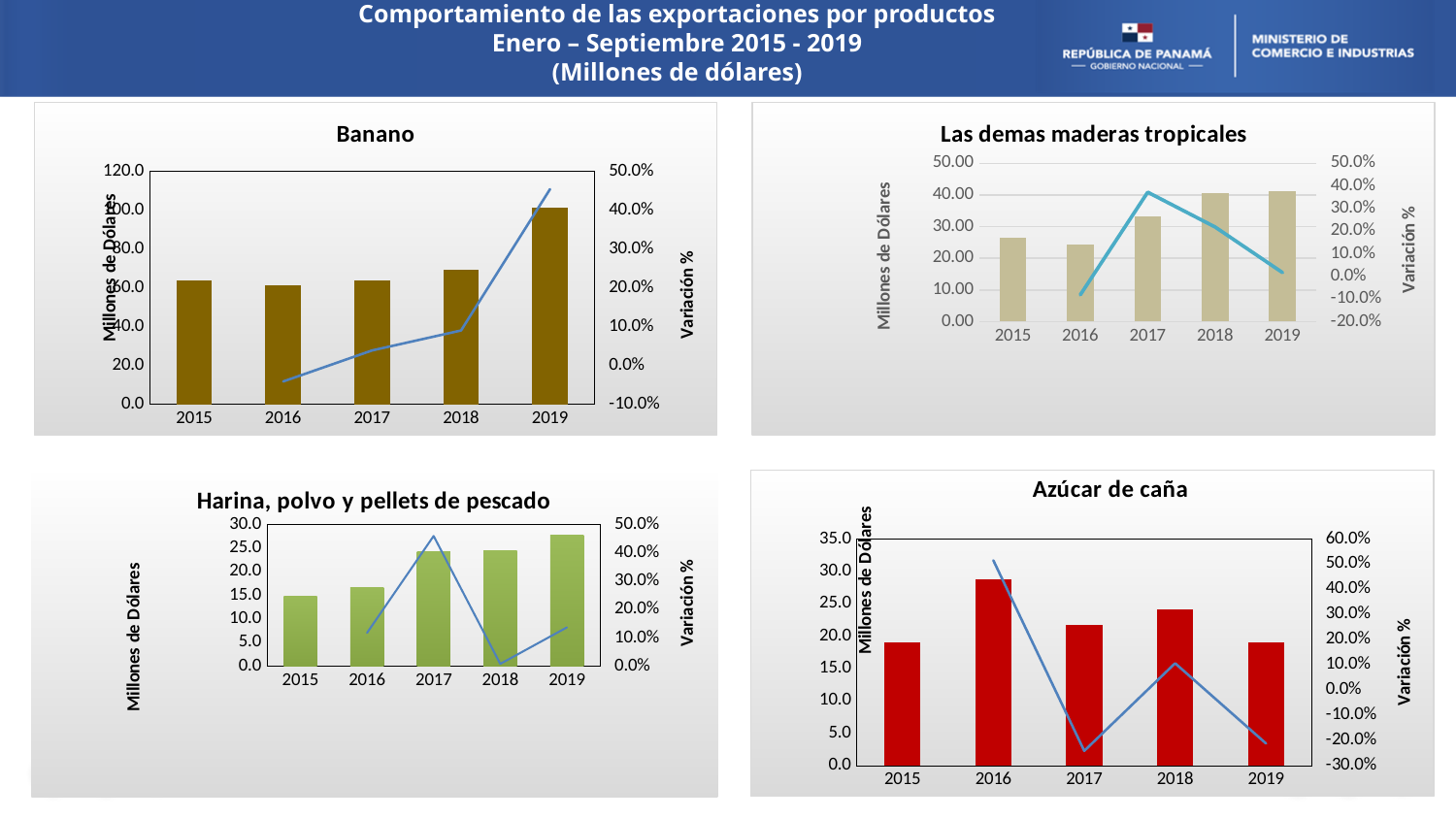
In the Banano chart, is the bar value for 2016 greater or less than 80.0? less In the Harina, polvo y pellets de pescado chart, which bar is taller, 2017 or 2015? 2017 In the Las demas maderas tropicales chart, is the bar value for 2017 greater or less than 30.00? greater In the Banano chart, does the Variación % line rise or fall from 2016 to 2019? rise What is the label of the left vertical axis in the Banano chart? Millones de Dólares In the Banano chart, which year has the highest bar? 2019 In the Las demas maderas tropicales chart, is the bar value for 2016 greater or less than 30.00? less How many years are shown on the x axis of the Azúcar de caña chart? 5 In the Azúcar de caña chart, which year has the highest bar? 2016 In the Harina, polvo y pellets de pescado chart, which year has the highest bar? 2019